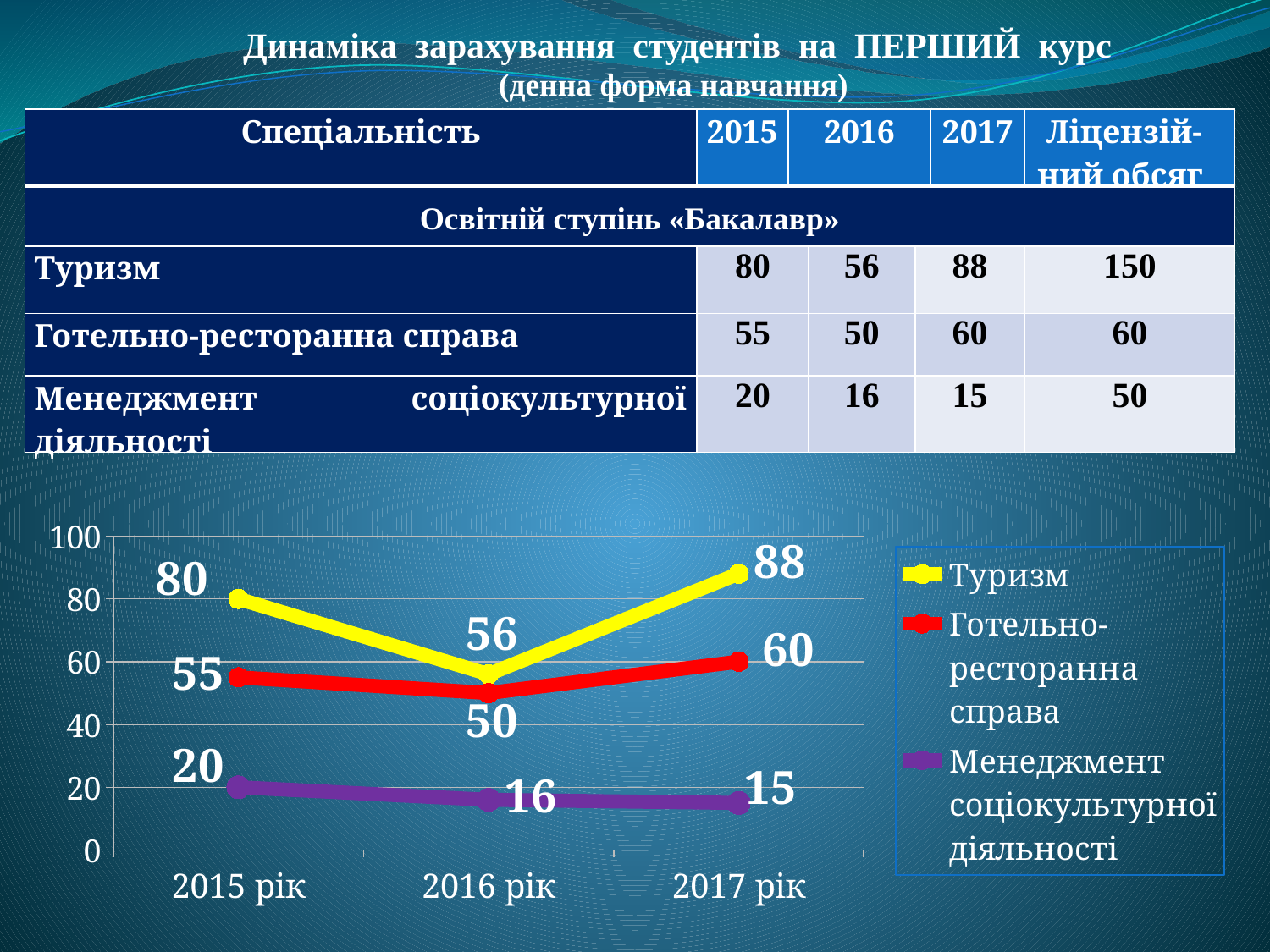
How many points are plotted along the x axis for each series? 3 Does the value for Менеджмент соціокультурної діяльності rise or fall from 2015 рік to 2017 рік? fall What is the value for Готельно-ресторанна справа in 2016 рік? 50 Which series has the highest value in 2017 рік? Туризм In which year is the value for Туризм lowest? 2016 рік What colour is the line for Туризм? yellow What is the value for Туризм in 2017 рік? 88 What is the value for Менеджмент соціокультурної діяльності in 2015 рік? 20 Which is larger: Готельно-ресторанна справа in 2015 рік or Туризм in 2016 рік? Туризм in 2016 рік What kind of chart is shown on the slide? line chart How many series does the chart legend list? 3 What is the difference between the Туризм values in 2017 рік and 2016 рік? 32